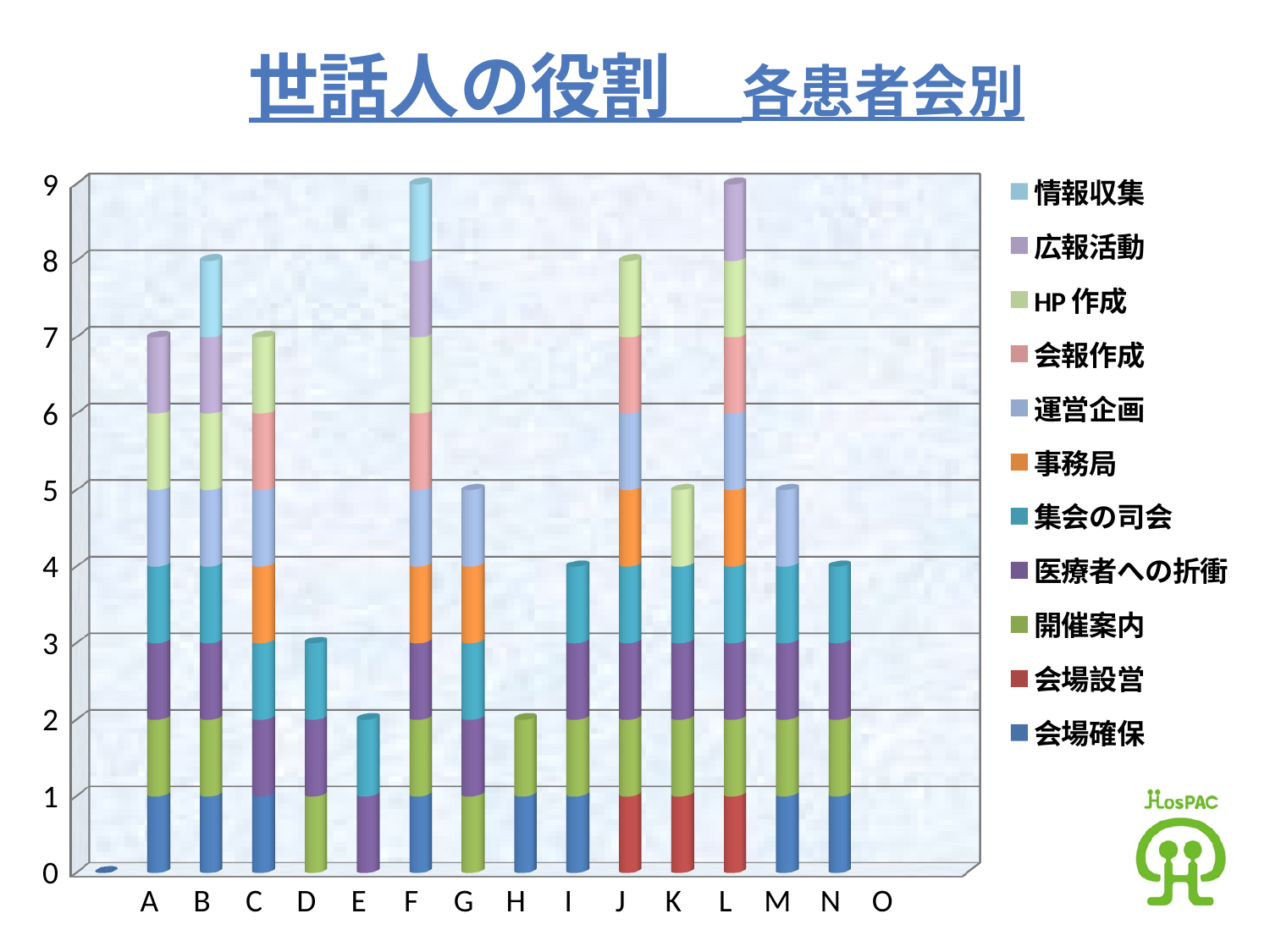
What is the total height of the stacked bar for category G? 5 What is the total height of the stacked bar for category B? 8 What is the total height of the stacked bar for category F? 9 What is the first entry listed at the top of the legend? 情報収集 What is the difference between the total for category F and the total for category D? 6 Which category has no bar at all? O Which is larger, the total for category B or the total for category D? B How many series does the legend list? 11 What kind of chart is shown on the slide? Stacked bar chart How many categories are shown along the x axis? 15 Is the total for category J greater or less than 6? greater